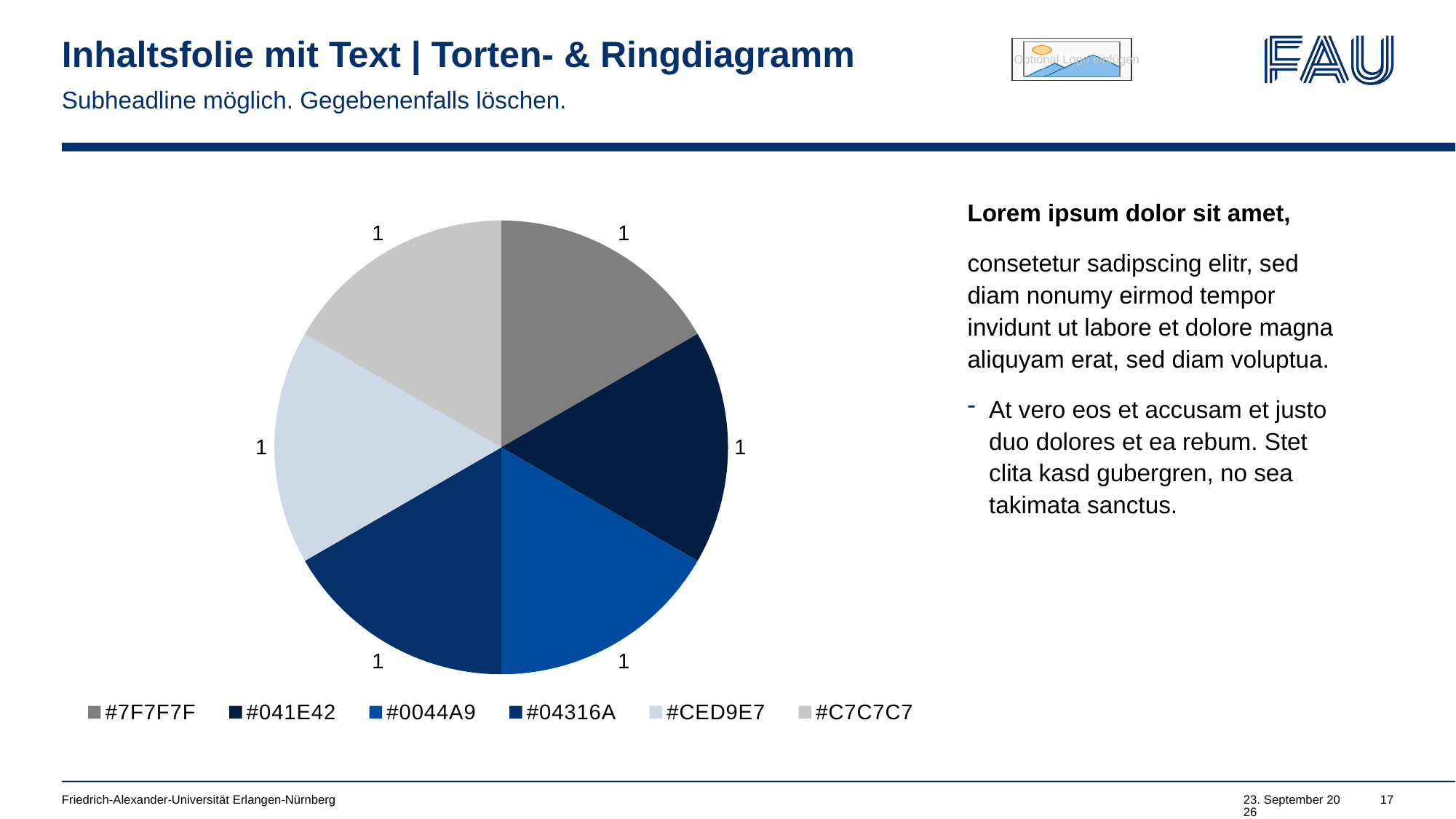
What is the difference between the values of the #041E42 slice and the #CED9E7 slice? 0 What is the value shown for the #C7C7C7 slice? 1 What share of the pie does the #04316A slice represent? 1/6 What is the value shown for the #7F7F7F slice? 1 Which legend entry is listed last in the pie chart's legend? #C7C7C7 How many entries does the legend of the pie chart list? 6 What kind of chart is shown on the slide? pie chart How many slices does the pie chart have? 6 Which legend entry is listed first in the pie chart's legend? #7F7F7F What is the value shown for the #0044A9 slice? 1 What is the total of all slice values in the pie chart? 6